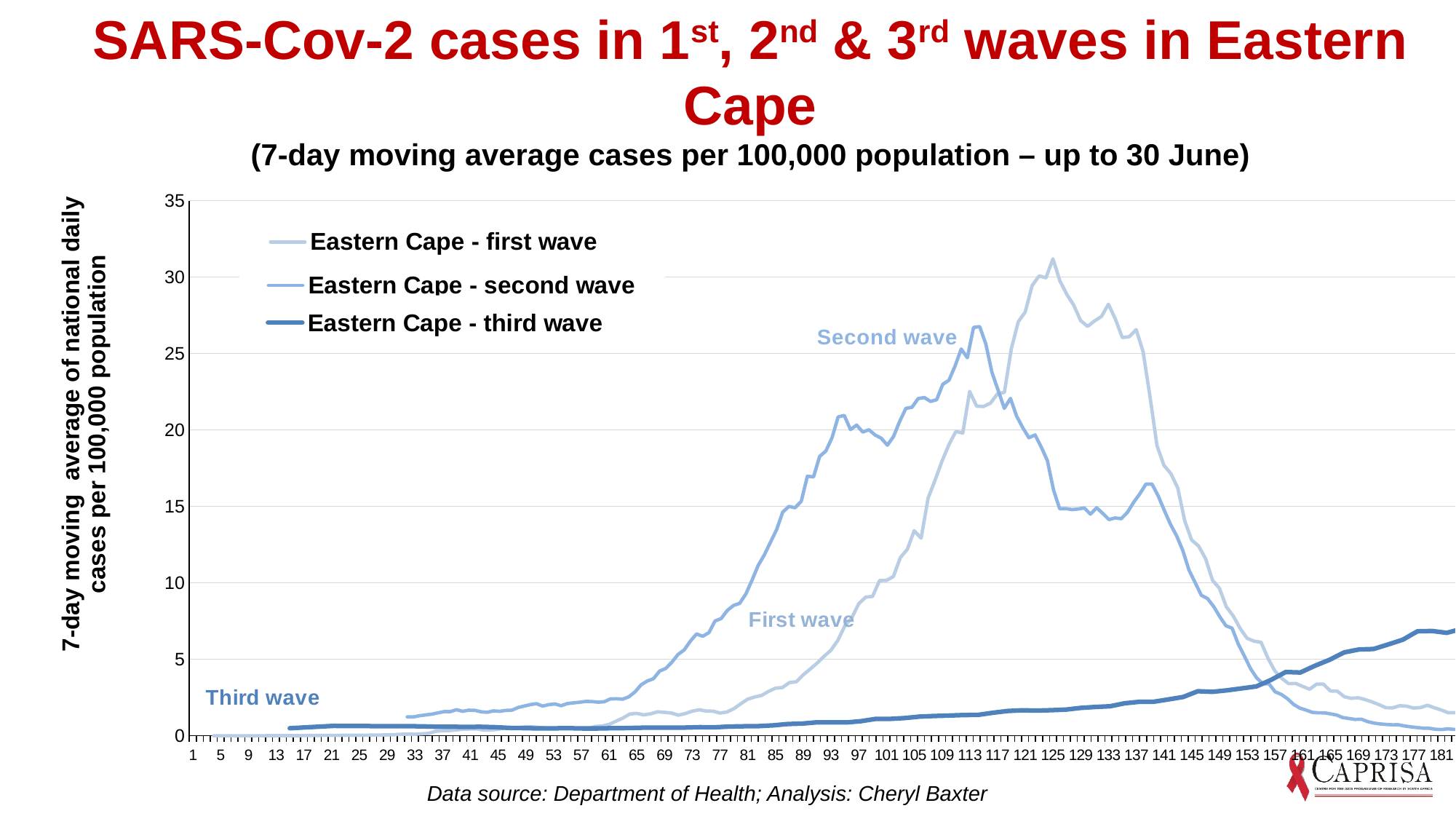
How many series does the legend list? 3 Is the peak value of the first wave greater or less than 25? greater Which wave has the lowest peak on the chart? Eastern Cape - third wave Which peaks higher, the first wave or the second wave? First wave What type of chart is shown on the slide? Line chart Is the value of the third wave at day 181 greater or less than 10? less What is the subtitle shown under the chart title? (7-day moving average cases per 100,000 population – up to 30 June) Which wave reaches the highest peak on the chart? Eastern Cape - first wave What is the highest value shown on the y axis? 35 Is the peak value of the second wave greater or less than 20? greater Does the third wave line rise or fall over the last part of the x axis (days 157 to 181)? Rises